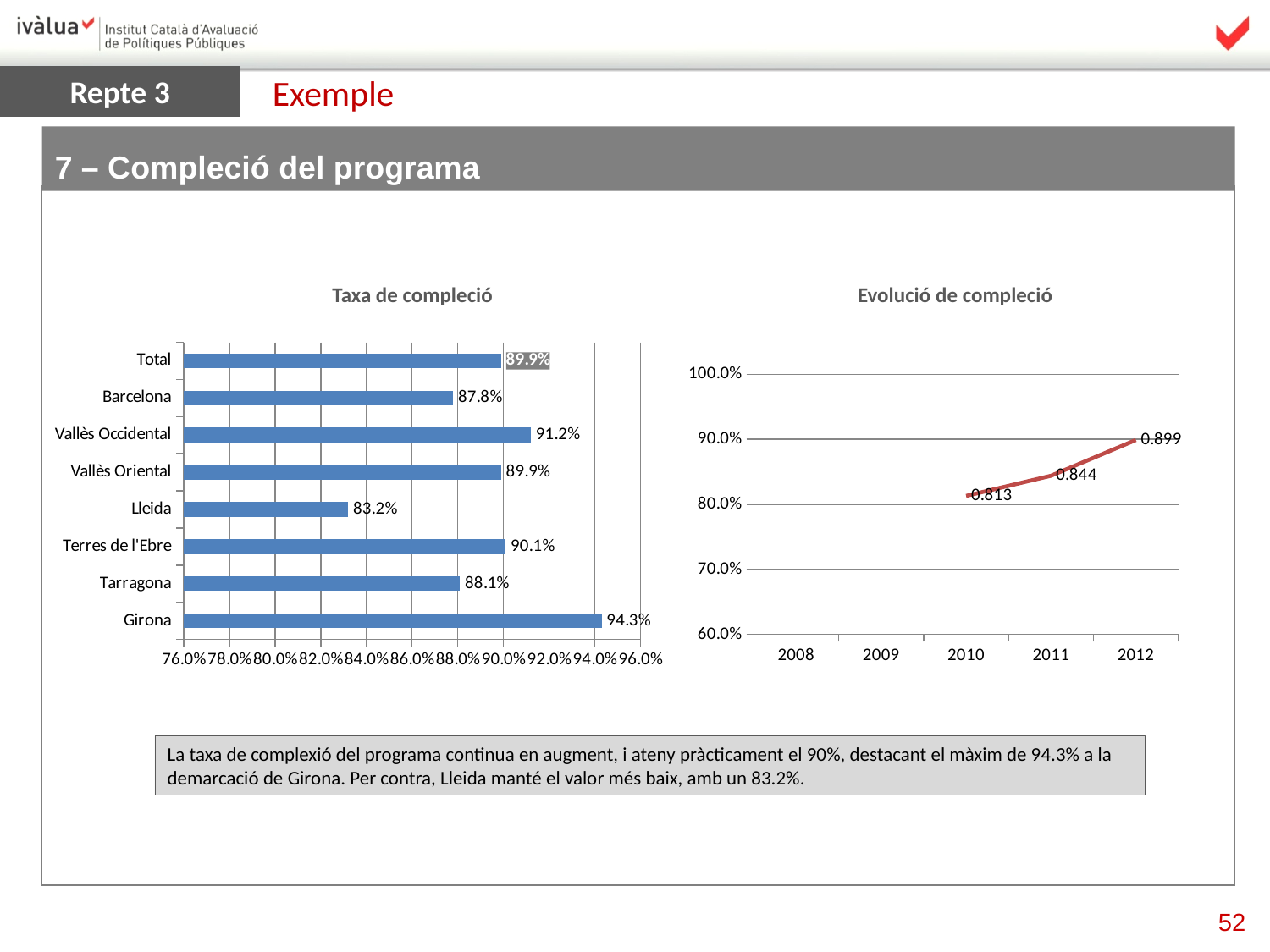
In the 'Evolució de compleció' chart, what is the value for 2011? 0.844 What kind of chart is 'Taxa de compleció'? Bar chart What kind of chart is 'Evolució de compleció'? Line chart In the 'Taxa de compleció' chart, what is the value for Girona? 94.3% In the 'Taxa de compleció' chart, which is larger, the value for Barcelona or the value for Tarragona? Tarragona In the 'Evolució de compleció' chart, do the values rise or fall from 2010 to 2012? Rise In the 'Taxa de compleció' chart, which category has the lowest value? Lleida In the 'Taxa de compleció' chart, how many categories are shown? 8 In the 'Taxa de compleció' chart, what is the difference between the values for Girona and Lleida? 11.1% In the 'Taxa de compleció' chart, what is the value for Lleida? 83.2% In the 'Taxa de compleció' chart, which category has the highest value? Girona In the 'Evolució de compleció' chart, what is the value for 2012? 0.899